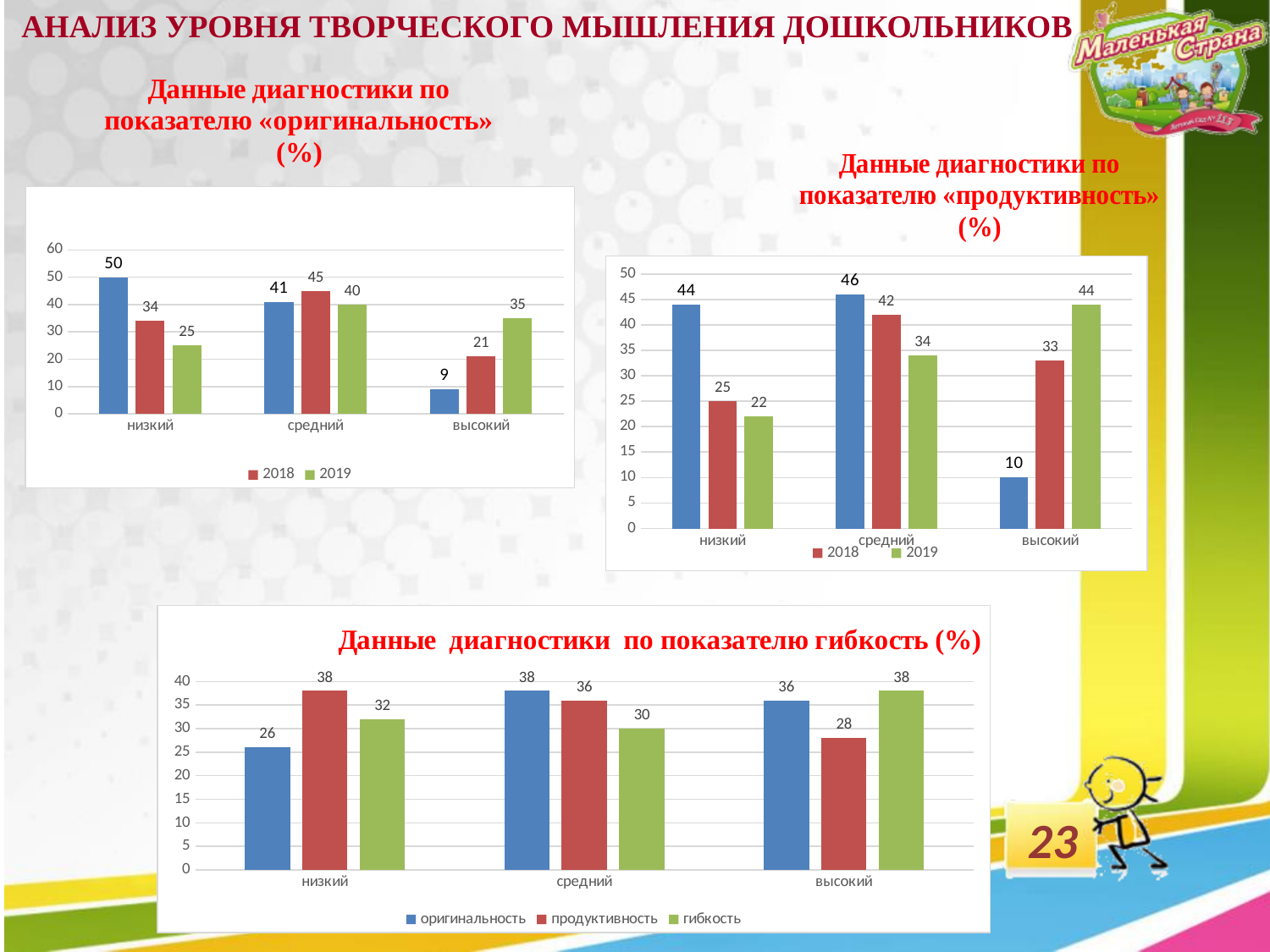
What kind of chart is «Данные диагностики по показателю гибкость (%)»? bar chart In the chart «Данные диагностики по показателю «оригинальность» (%)», which category has the lowest 2019 value? низкий In the chart «Данные диагностики по показателю «продуктивность» (%)», what is the 2019 value for «высокий»? 44 In the chart «Данные диагностики по показателю гибкость (%)», what is the difference between «продуктивность» and «оригинальность» for «низкий»? 12 In the chart «Данные диагностики по показателю «оригинальность» (%)», what is the 2018 value for the category «средний»? 45 In the chart «Данные диагностики по показателю гибкость (%)», how many series does the legend list? 3 In the chart «Данные диагностики по показателю «продуктивность» (%)», which category has the highest 2018 value? средний In the chart «Данные диагностики по показателю гибкость (%)», what is the value of «продуктивность» for «высокий»? 28 In the chart «Данные диагностики по показателю «продуктивность» (%)», is the 2018 value for «низкий» or the 2019 value for «низкий» larger? 2018 In the chart «Данные диагностики по показателю «оригинальность» (%)», what is the 2019 value for the category «высокий»? 35 In the chart «Данные диагностики по показателю «продуктивность» (%)», how many categories are shown on the x axis? 3 In the chart «Данные диагностики по показателю «оригинальность» (%)», what is the difference between the 2018 and 2019 values for «низкий»? 9